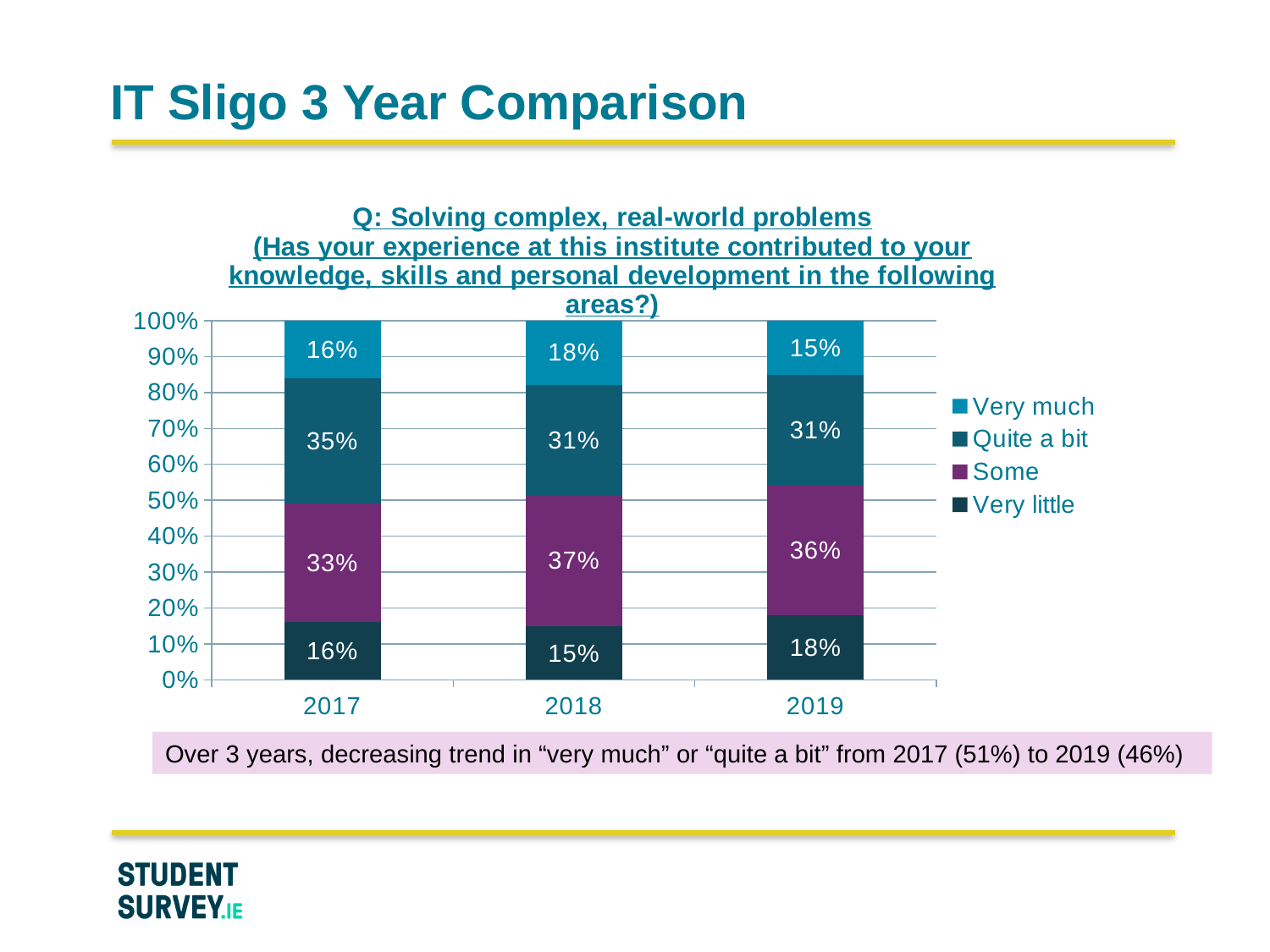
What percentage of respondents answered "Very much" in 2018? 18% How many series does the legend list? 4 In which year was the "Very much" share highest? 2018 What is the value for "Quite a bit" in 2017? 35% What is the value for "Some" in 2019? 36% What is the difference between the "Some" values for 2018 and 2017? 4% What kind of chart is shown on the slide? Stacked bar chart In which year was the "Very little" share lowest? 2018 What is the combined total of "Very much" and "Quite a bit" in 2019? 46% How many years are shown on the x axis? 3 What is the value for "Very little" in 2017? 16% Which is larger: "Quite a bit" in 2017 or "Quite a bit" in 2019? 2017